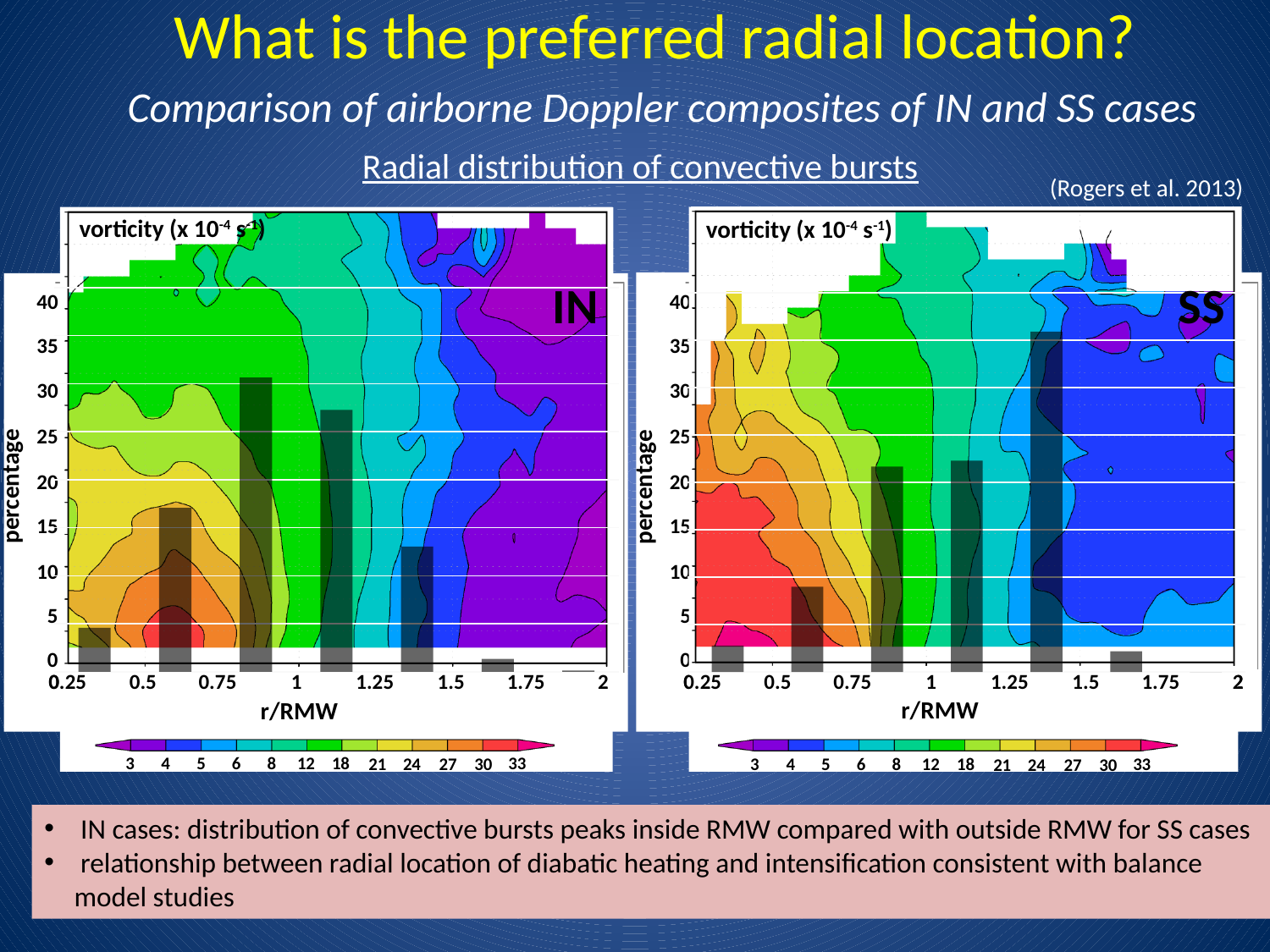
In the IN chart (left panel), is the tallest bar located at r/RMW less than 1 or greater than 1? less than 1 In the SS chart (right panel), is the value of the bar between r/RMW 0.5 and 0.75 greater or less than 10? less What is the label on the x axis of both charts? r/RMW In the IN chart (left panel), is the value of the bar between r/RMW 0.5 and 0.75 greater or less than 20? less In the IN chart (left panel), which bar is taller: the one between r/RMW 0.5 and 0.75 or the one between r/RMW 1.25 and 1.5? the one between 0.5 and 0.75 What kind of chart is overlaid on the vorticity contour plots in the IN and SS panels? bar chart How many bars are plotted in the IN chart (left panel)? 6 What is the label on the y axis of both charts? percentage In the SS chart (right panel), is the tallest bar located at r/RMW less than 1 or greater than 1? greater than 1 How many bars are plotted in the SS chart (right panel)? 6 In the SS chart (right panel), is the value of the bar between r/RMW 1.25 and 1.5 greater or less than 30? greater